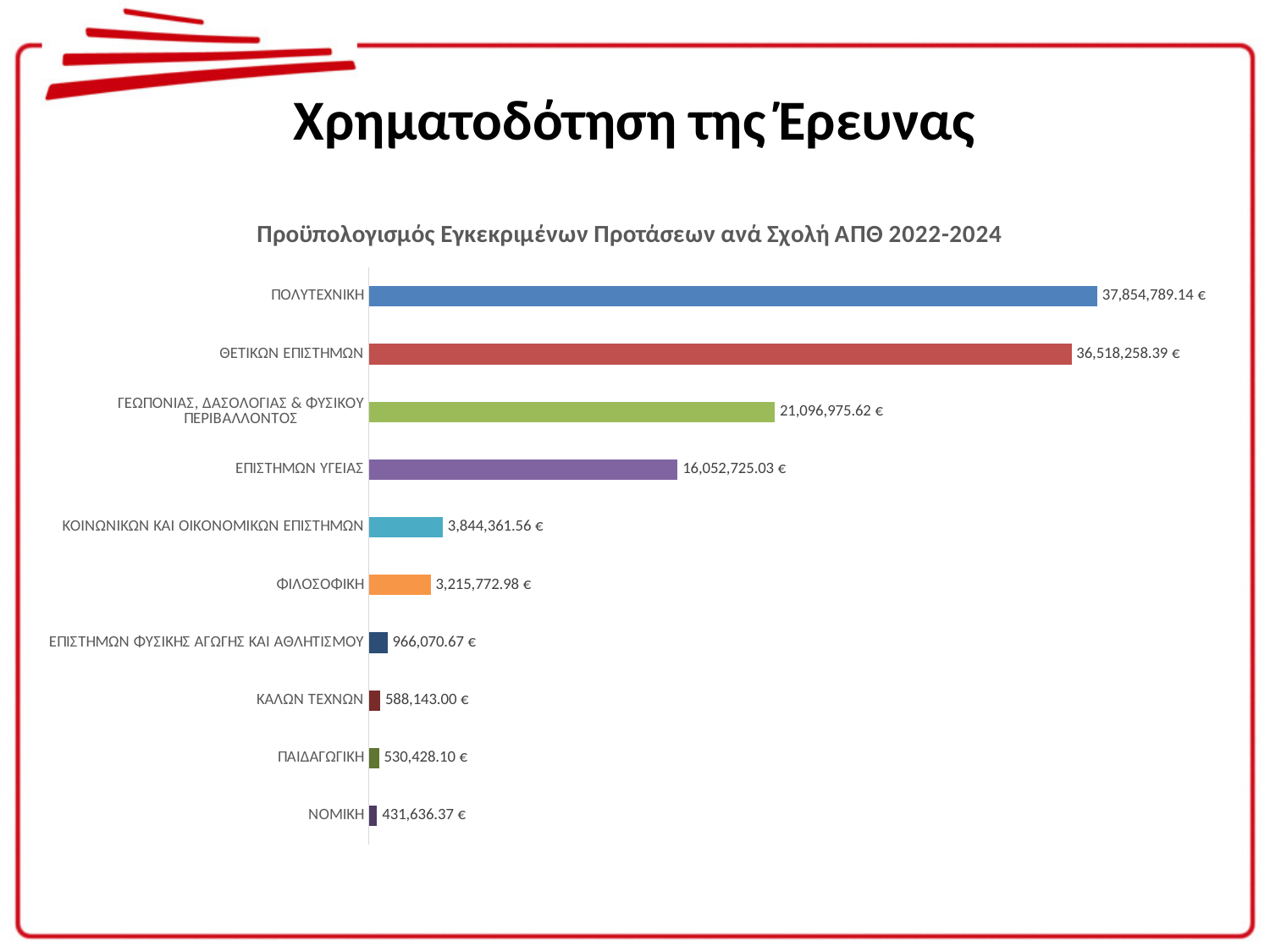
What is the difference between the values for ΚΑΛΩΝ ΤΕΧΝΩΝ and ΠΑΙΔΑΓΩΓΙΚΗ? 57,714.90 € Which school has the highest value? ΠΟΛΥΤΕΧΝΙΚΗ What is the difference between the values for ΠΟΛΥΤΕΧΝΙΚΗ and ΘΕΤΙΚΩΝ ΕΠΙΣΤΗΜΩΝ? 1,336,530.75 € How many schools are shown in the chart? 10 Which is larger, the value for ΚΟΙΝΩΝΙΚΩΝ ΚΑΙ ΟΙΚΟΝΟΜΙΚΩΝ ΕΠΙΣΤΗΜΩΝ or the value for ΦΙΛΟΣΟΦΙΚΗ? ΚΟΙΝΩΝΙΚΩΝ ΚΑΙ ΟΙΚΟΝΟΜΙΚΩΝ ΕΠΙΣΤΗΜΩΝ Which school has the lowest value? ΝΟΜΙΚΗ What kind of chart is shown on the slide? Bar chart What is the value for ΠΟΛΥΤΕΧΝΙΚΗ? 37,854,789.14 € What is the value for ΝΟΜΙΚΗ? 431,636.37 € What is the title of the chart? Προϋπολογισμός Εγκεκριμένων Προτάσεων ανά Σχολή ΑΠΘ 2022-2024 What is the value for ΦΙΛΟΣΟΦΙΚΗ? 3,215,772.98 € What is the value for ΕΠΙΣΤΗΜΩΝ ΥΓΕΙΑΣ? 16,052,725.03 €